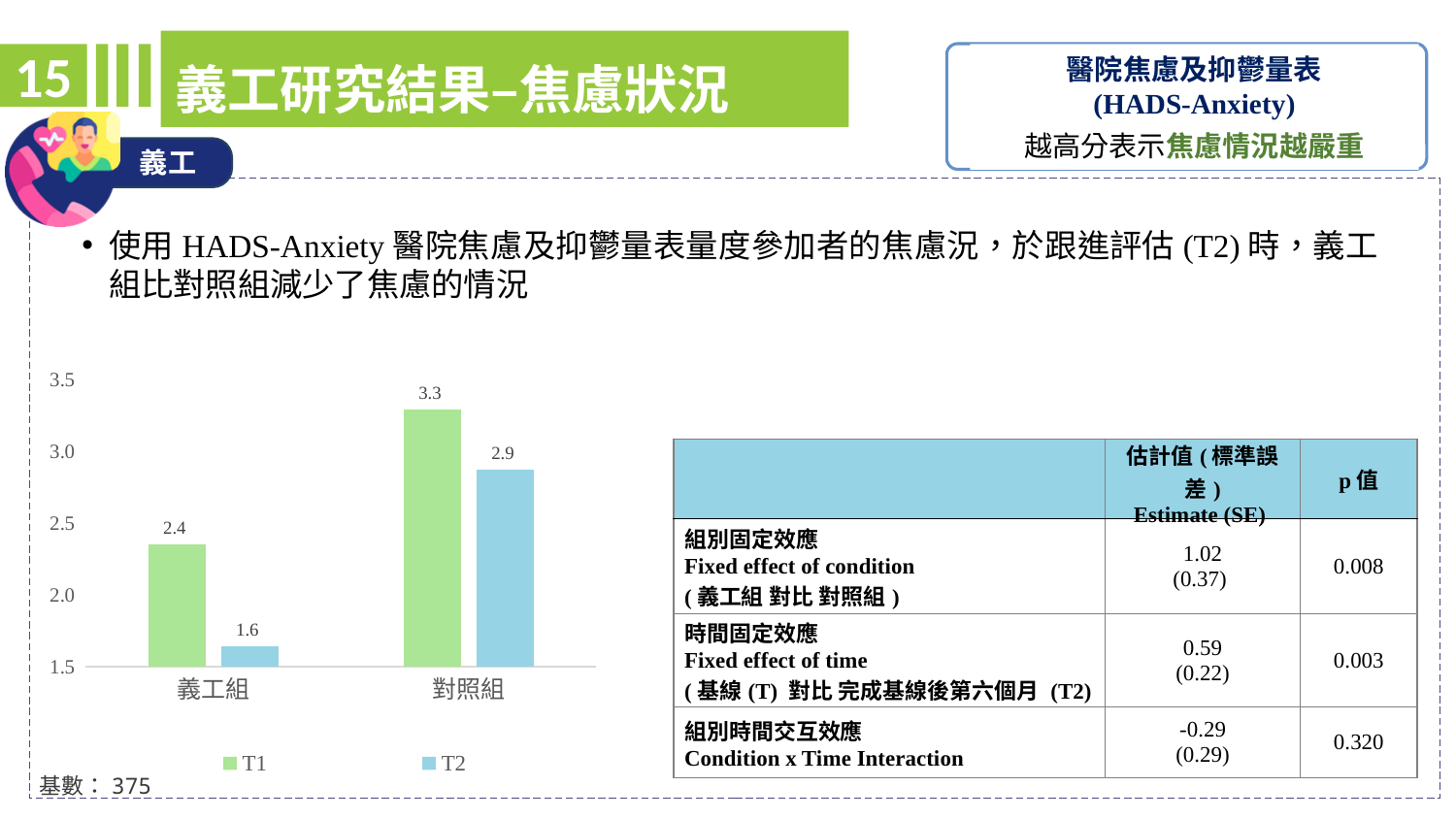
What type of chart is shown on the slide? Bar chart Which is larger, the T2 value for 義工組 or the T2 value for 對照組? 對照組 What is the difference between the T1 and T2 values for 義工組? 0.8 What is the T1 value for 義工組 in the bar chart? 2.4 Which bar in the chart has the lowest value? 義工組 T2 How many series does the chart legend list? 2 How many categories are shown on the x axis of the bar chart? 2 What is the difference between the T1 and T2 values for 對照組? 0.4 What is the T2 value for 對照組 in the bar chart? 2.9 What is the T2 value for 義工組 in the bar chart? 1.6 What is the T1 value for 對照組 in the bar chart? 3.3 Which bar in the chart has the highest value? 對照組 T1